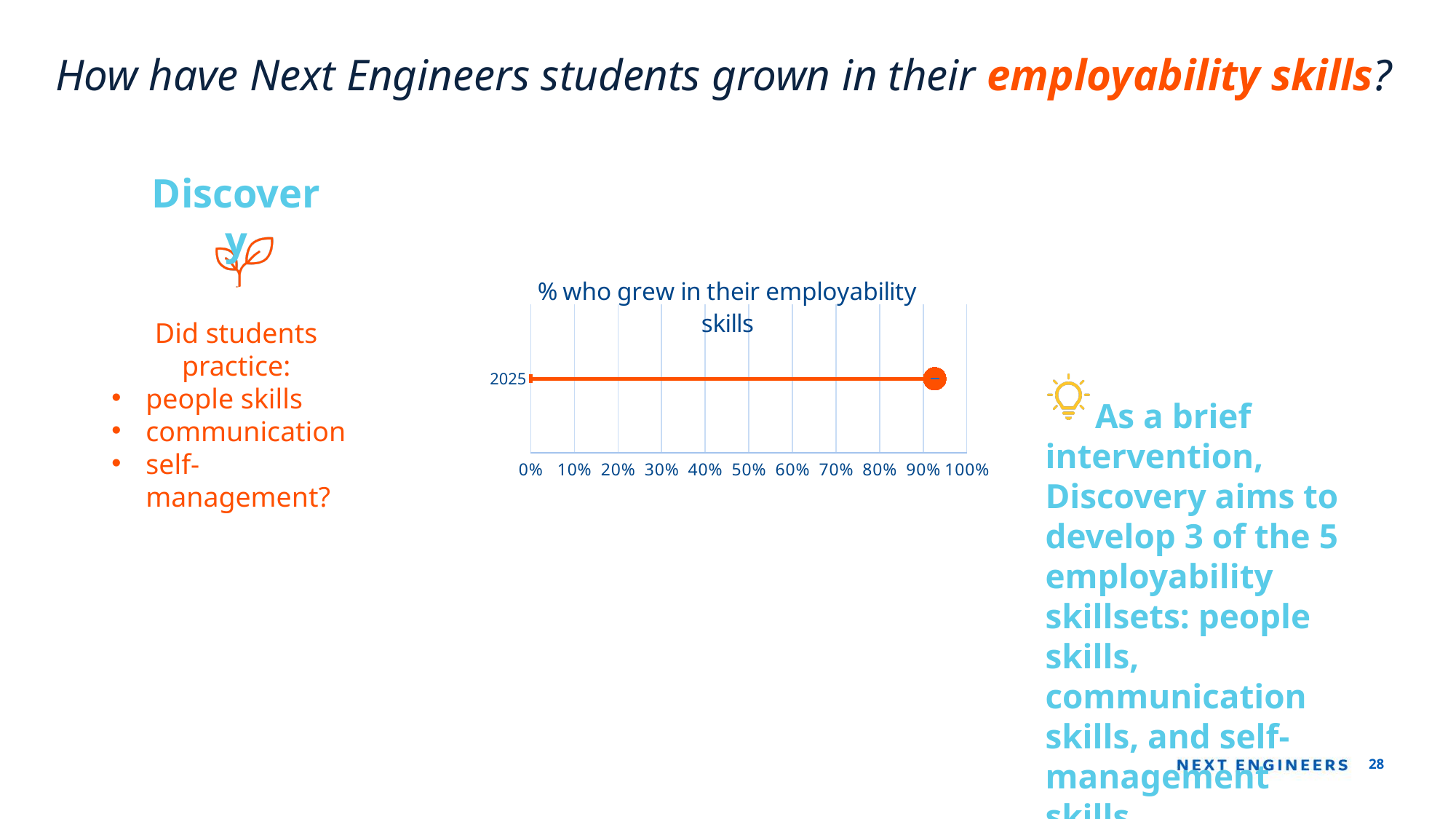
What is the title of the chart? % who grew in their employability skills Is the value for 2025 greater or less than 100%? less Is the value for 2025 greater or less than 50%? greater What is the label of the single category plotted in the chart? 2025 Is the value for 2025 greater or less than 80%? greater What is the highest value shown on the chart's horizontal axis? 100% What kind of chart is shown on the slide? bar chart How many categories are plotted in the chart? 1